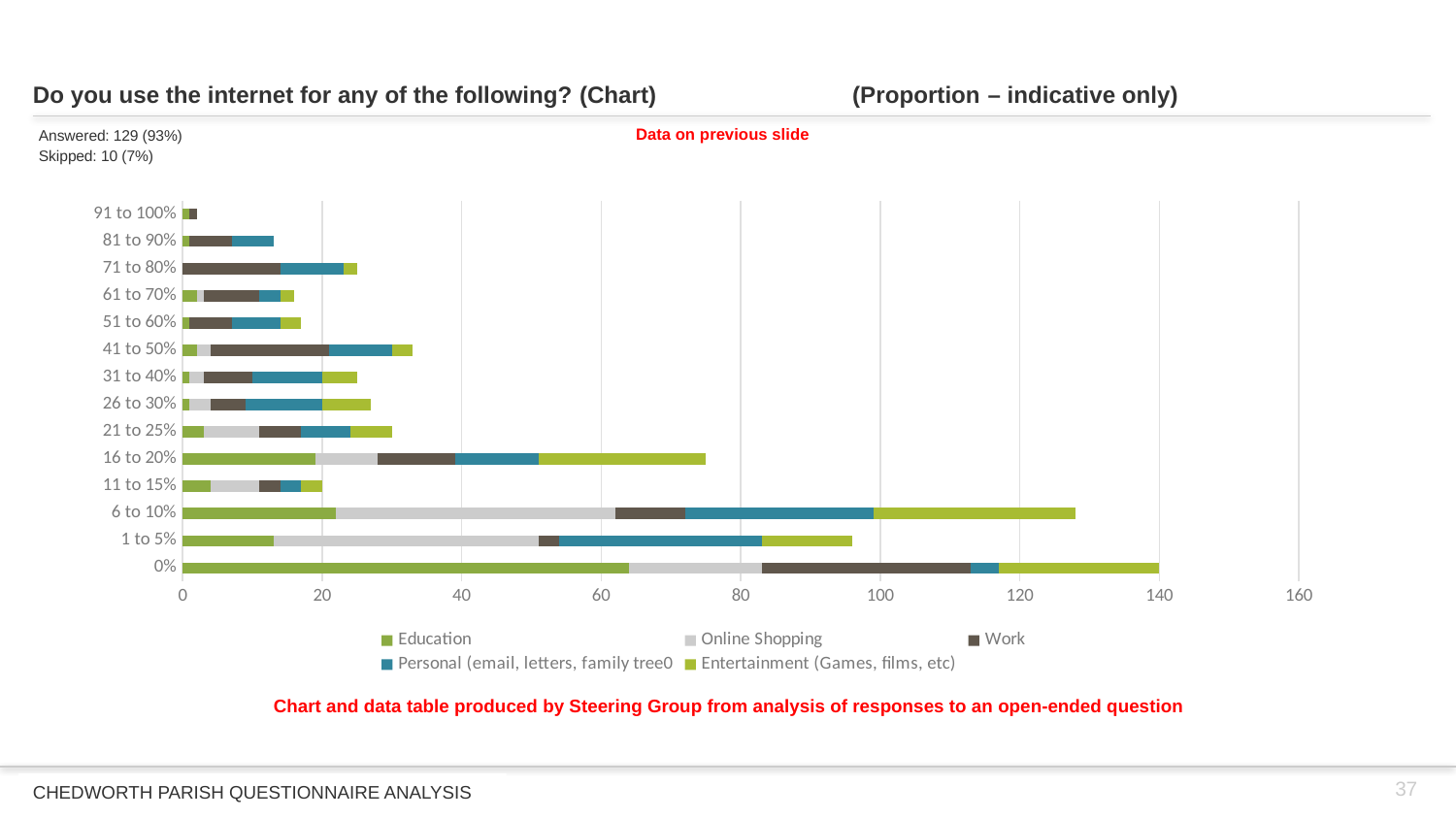
How many categories are shown on the vertical axis of the chart? 14 Which has the longer total bar, 6 to 10% or 1 to 5%? 6 to 10% Which series is shown in the darkest (dark grey) colour in the chart legend? Work Is the total bar length for the 16 to 20% category greater or less than 60? greater Which has the longer total bar, 16 to 20% or 21 to 25%? 16 to 20% Which category has the longest total bar in the chart? 0% Is the total bar length for the 1 to 5% category greater or less than 100? less What kind of chart is shown on the slide? Stacked bar chart Is the total bar length for the 6 to 10% category greater or less than 100? greater Which category has the shortest total bar in the chart? 91 to 100% How many series does the chart legend list? 5